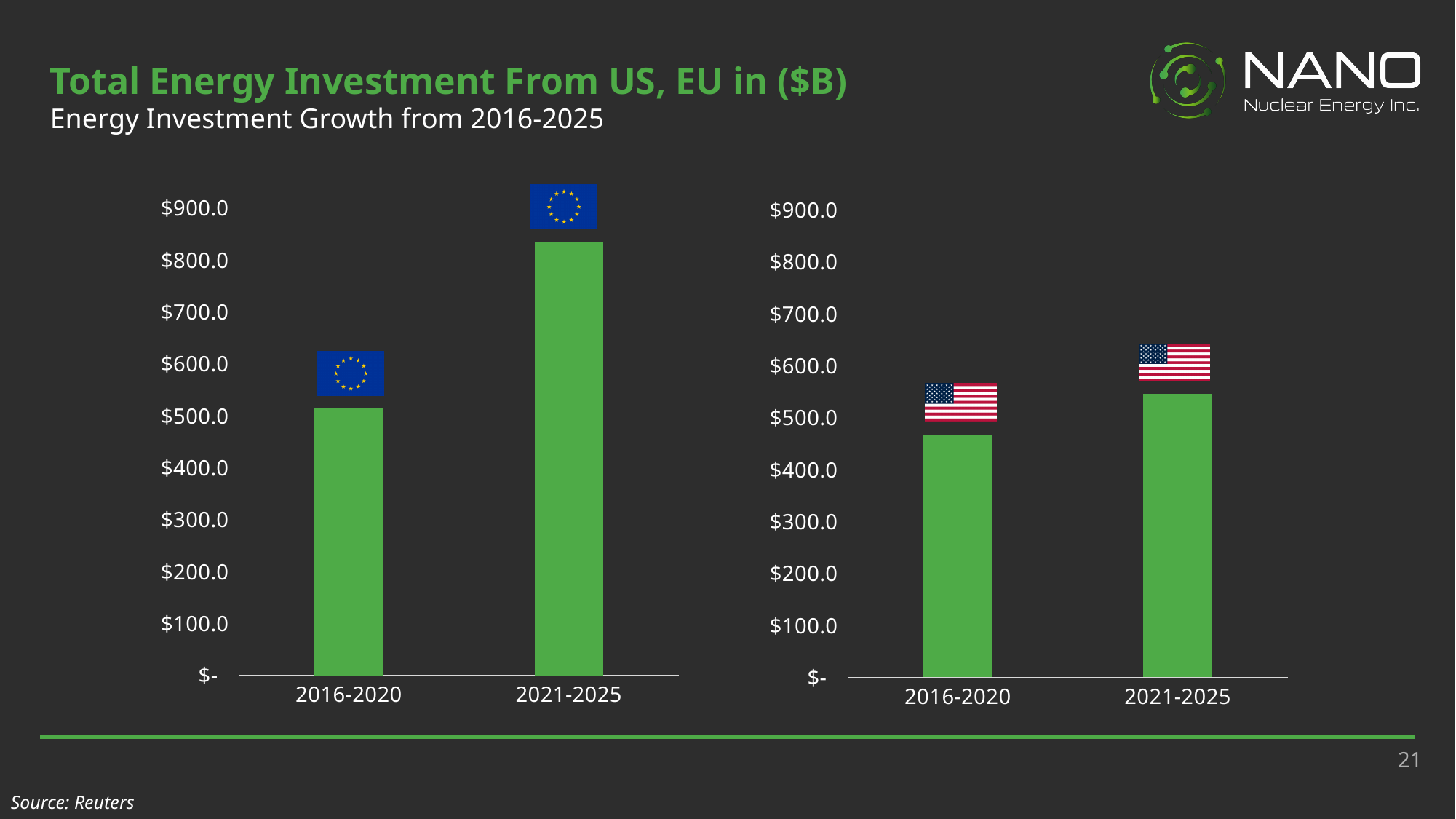
What is the title of the slide's chart section? Total Energy Investment From US, EU in ($B) In the left chart (EU), which period has the higher bar? 2021-2025 Comparing the 2021-2025 bars, is the left chart (EU) or the right chart (US) larger? left chart (EU) In the right chart (US), do the values rise or fall from 2016-2020 to 2021-2025? rise In the right chart (US), is the value for 2016-2020 greater or less than $500.0? less How many categories are shown on the x axis of the right chart? 2 In the left chart (EU), is the value for 2021-2025 greater or less than $800.0? greater What kind of chart is the left chart on the slide? bar chart What is the highest value labelled on the y axis of the left chart? $900.0 In the right chart (US), which period has the lower bar? 2016-2020 In the left chart (EU), is the value for 2016-2020 greater or less than $600.0? less